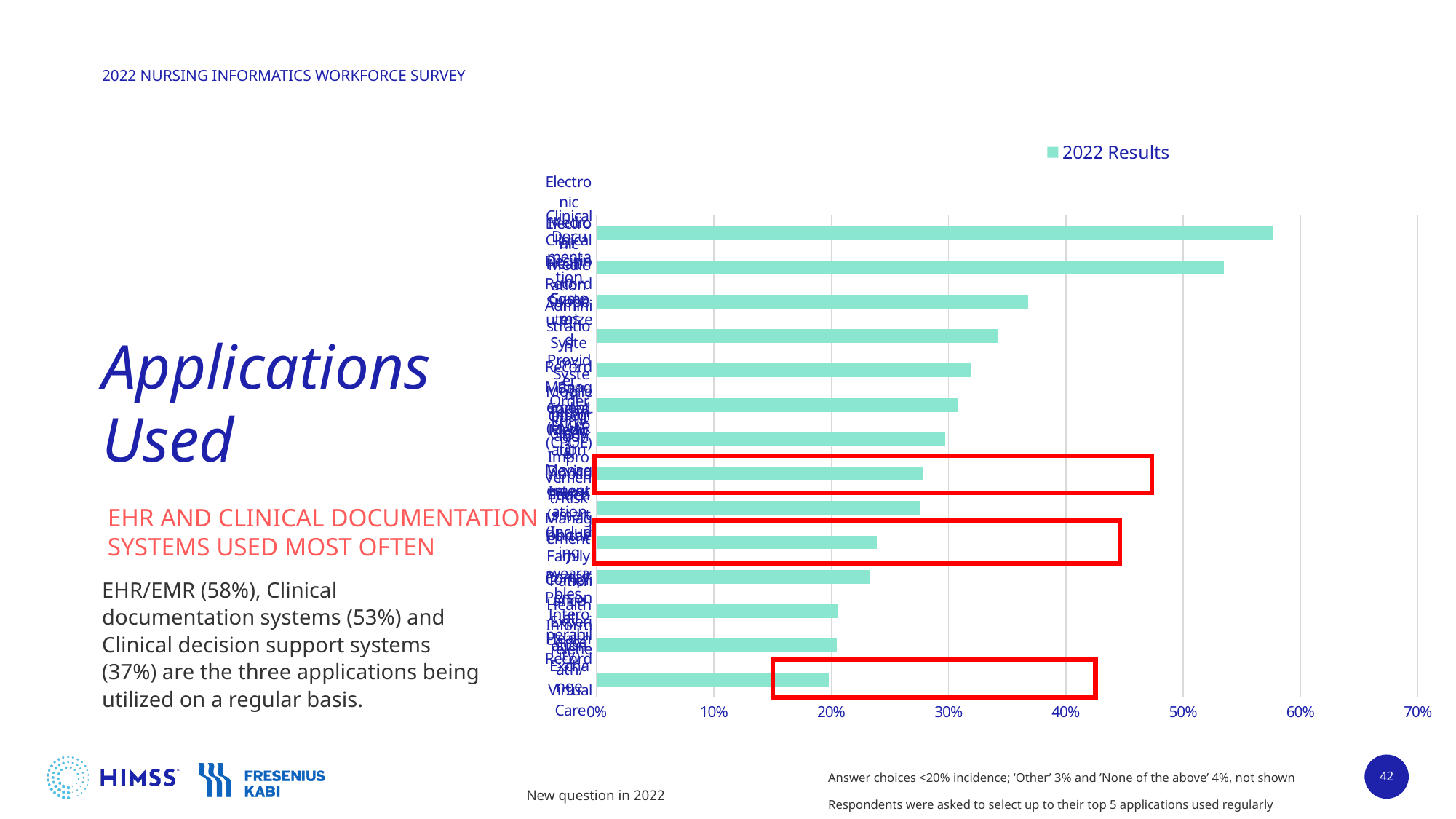
Is the value of the bottom bar greater or less than 30%? less How many bars are plotted in the chart? 14 What is the name of the series shown in the chart legend? 2022 Results Do the bar values increase or decrease going from the top of the chart to the bottom? decrease What kind of chart is shown on the slide? bar chart Is the top bar longer or shorter than the second bar from the top? longer Is the value of the top (longest) bar greater or less than 50%? greater Is the value of the third bar from the top greater or less than 40%? less How many series does the chart legend list? 1 What is the highest value shown on the chart's horizontal axis? 70%